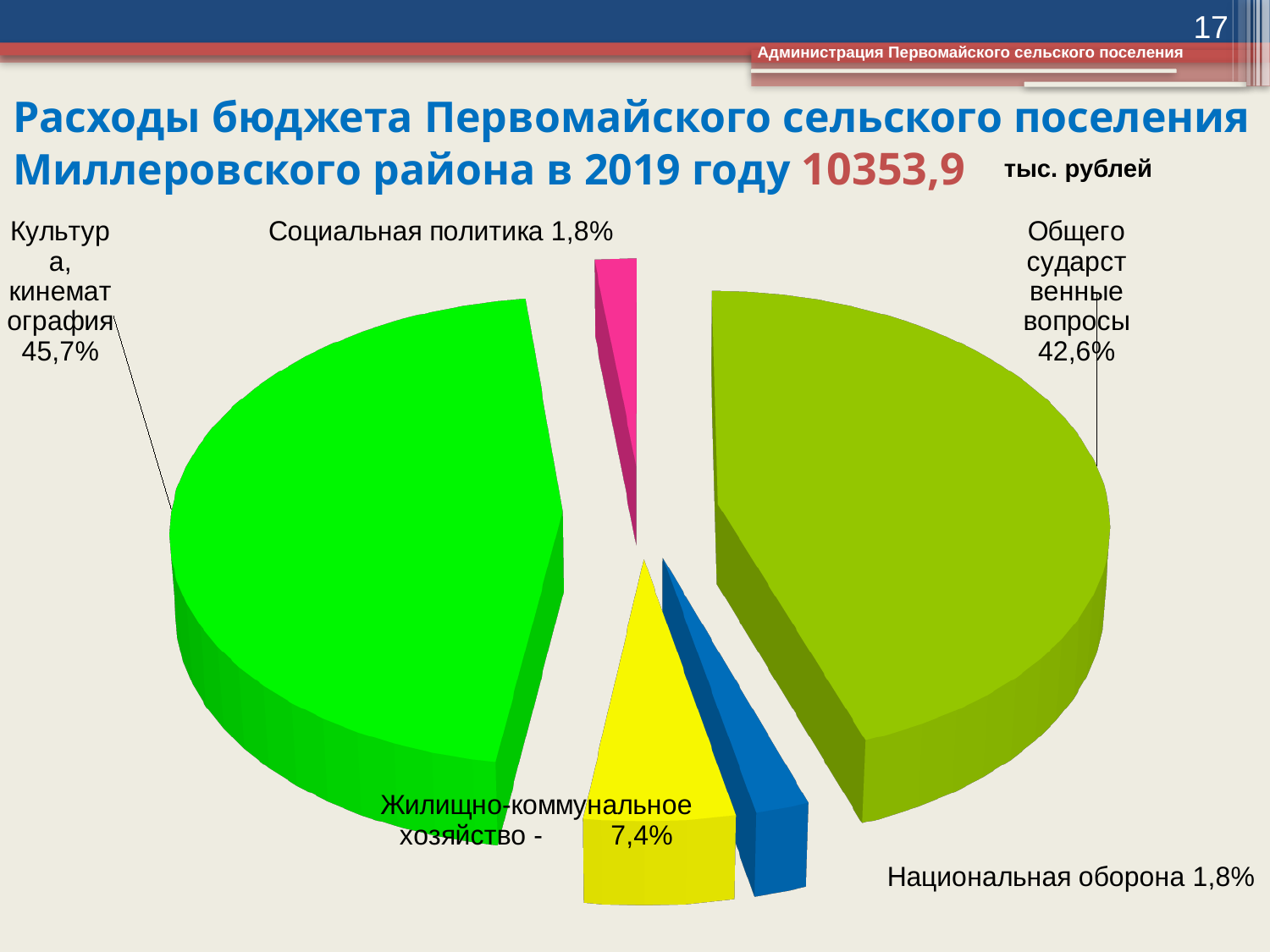
What is the difference in percentage points between Культура, кинематография and Общегосударственные вопросы? 3,1 Which is larger: the share for Жилищно-коммунальное хозяйство or the share for Социальная политика? Жилищно-коммунальное хозяйство What share of the budget expenditure goes to Жилищно-коммунальное хозяйство? 7,4% Which category has the largest share of the budget expenditure? Культура, кинематография What share of the budget expenditure goes to Национальная оборона? 1,8% What share of the budget expenditure goes to Общегосударственные вопросы? 42,6% What colour is the slice for Социальная политика? pink What share of the budget expenditure goes to Культура, кинематография? 45,7% What share of the budget expenditure goes to Социальная политика? 1,8% What is the total budget expenditure shown in the slide title, in тыс. рублей? 10353,9 What kind of chart is shown on the slide? pie chart How many categories (slices) does the pie chart show? 5